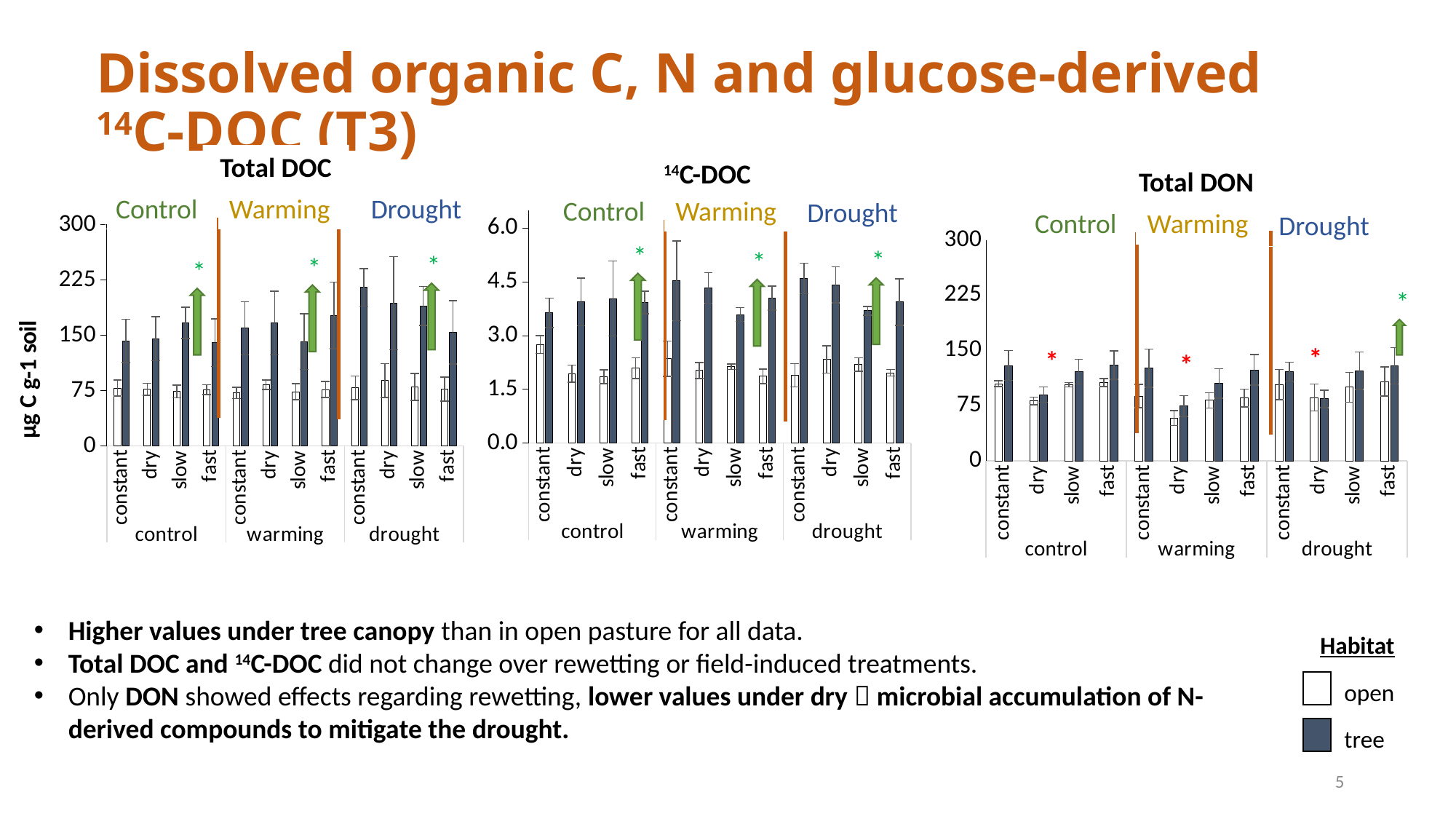
What is the y-axis label of the Total DOC chart? µg C g-1 soil In the 14C-DOC chart, is the open value for slow under drought greater or less than 3.0? less In the 14C-DOC chart, is the tree value for dry under control greater or less than 3.0? greater In the Total DOC chart, which is larger for constant under drought: the open value or the tree value? tree In the Total DOC chart, is the tree value for constant under drought greater or less than 150? greater In the Total DON chart, which bar is the lowest? open, dry under warming What kind of chart is the Total DOC chart? bar chart How many series does the Habitat legend list for the charts? 2 In the Total DON chart, how many rewetting categories are plotted along the x axis in total? 12 In the Total DOC chart, which bar is the highest? tree, constant under drought